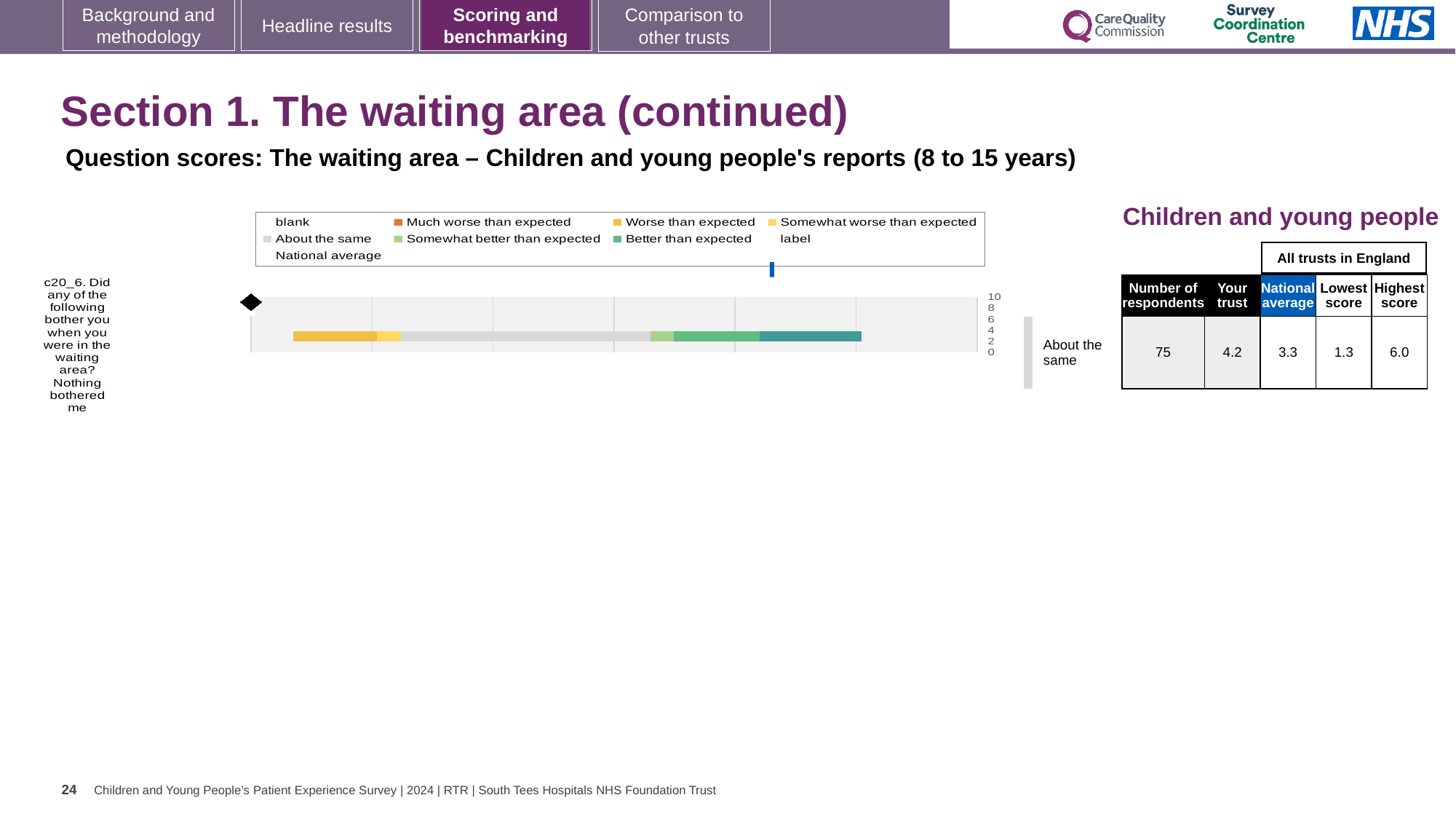
What is the maximum value shown on the chart's score axis? 10 What is the highest score among all trusts in England for question c20_6? 6.0 What is the benchmark result label shown to the right of the bar for question c20_6? About the same What is the national average score for question c20_6? 3.3 What is the lowest score among all trusts in England for question c20_6? 1.3 Which is larger for question c20_6: the 'Your trust' score or the national average? Your trust What is the difference between the highest and lowest scores among all trusts in England for question c20_6? 4.7 How many respondents answered question c20_6? 75 What is the difference between the 'Your trust' score and the national average for question c20_6? 0.9 What kind of chart is shown on the slide? Bar chart How many questions (categories) are plotted in the chart? 1 What is the 'Your trust' score for question c20_6 in the Children and young people table? 4.2